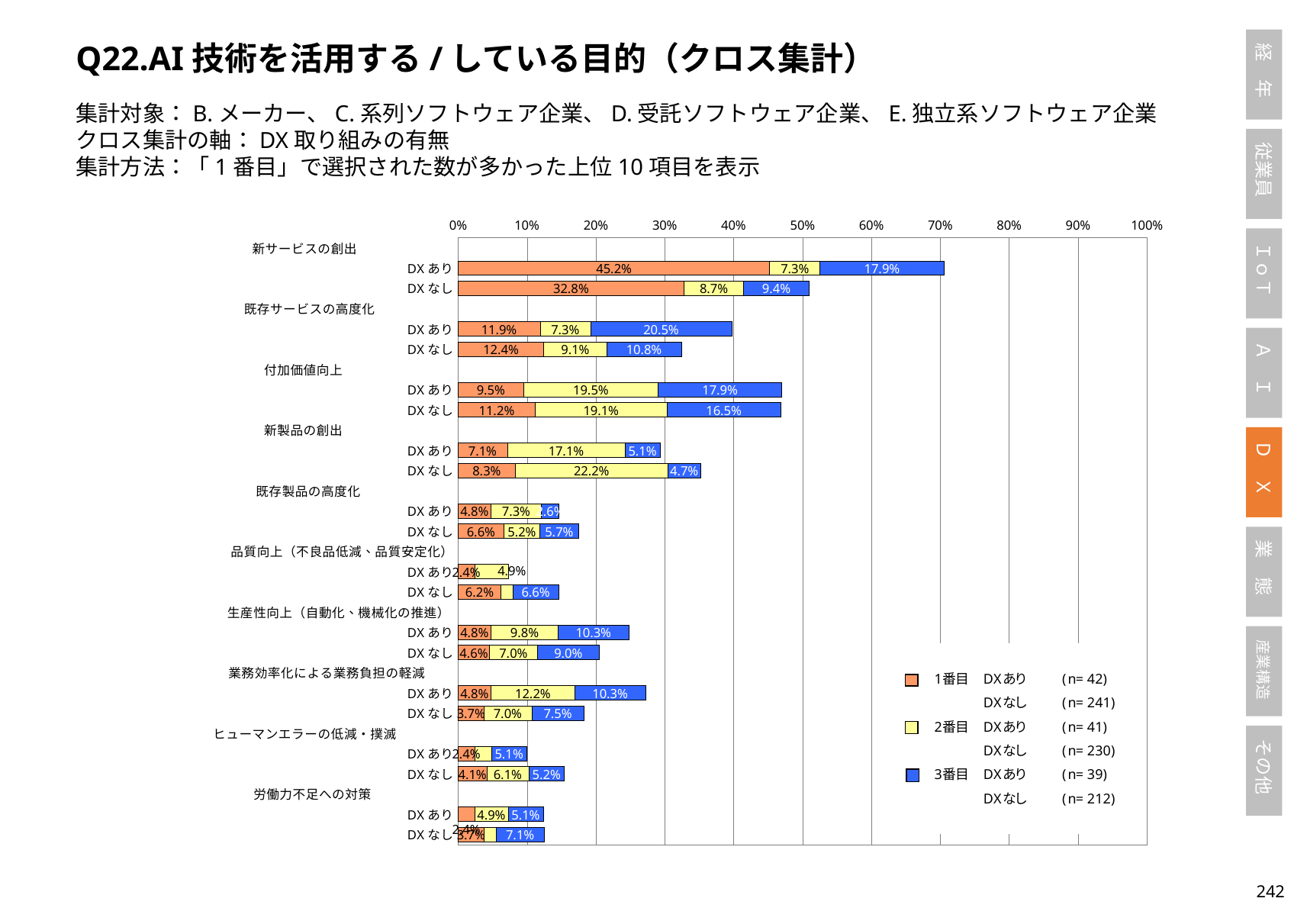
What is the total of the stacked bar for 新サービスの創出 DXあり? 70.4% What is the difference between the 1番目 values of 新サービスの創出 for DXあり and DXなし? 12.4% How many purpose categories are shown on the chart? 10 What is the 2番目 value for 新製品の創出 in the DXなし row? 22.2% Is the total stacked bar for 新サービスの創出 DXなし greater or less than 50%? greater What is the 3番目 value for 既存サービスの高度化 in the DXあり row? 20.5% What is the 1番目 value for 新サービスの創出 in the DXあり row? 45.2% Which is larger: the 2番目 value for 付加価値向上 DXあり or for 付加価値向上 DXなし? 付加価値向上 DXあり How many series does the legend list? 3 What kind of chart is shown on the slide? Stacked bar chart What is the sample size (n) shown in the legend for 1番目 DXなし? 241 Which category has the highest 1番目 value in the DXあり rows? 新サービスの創出